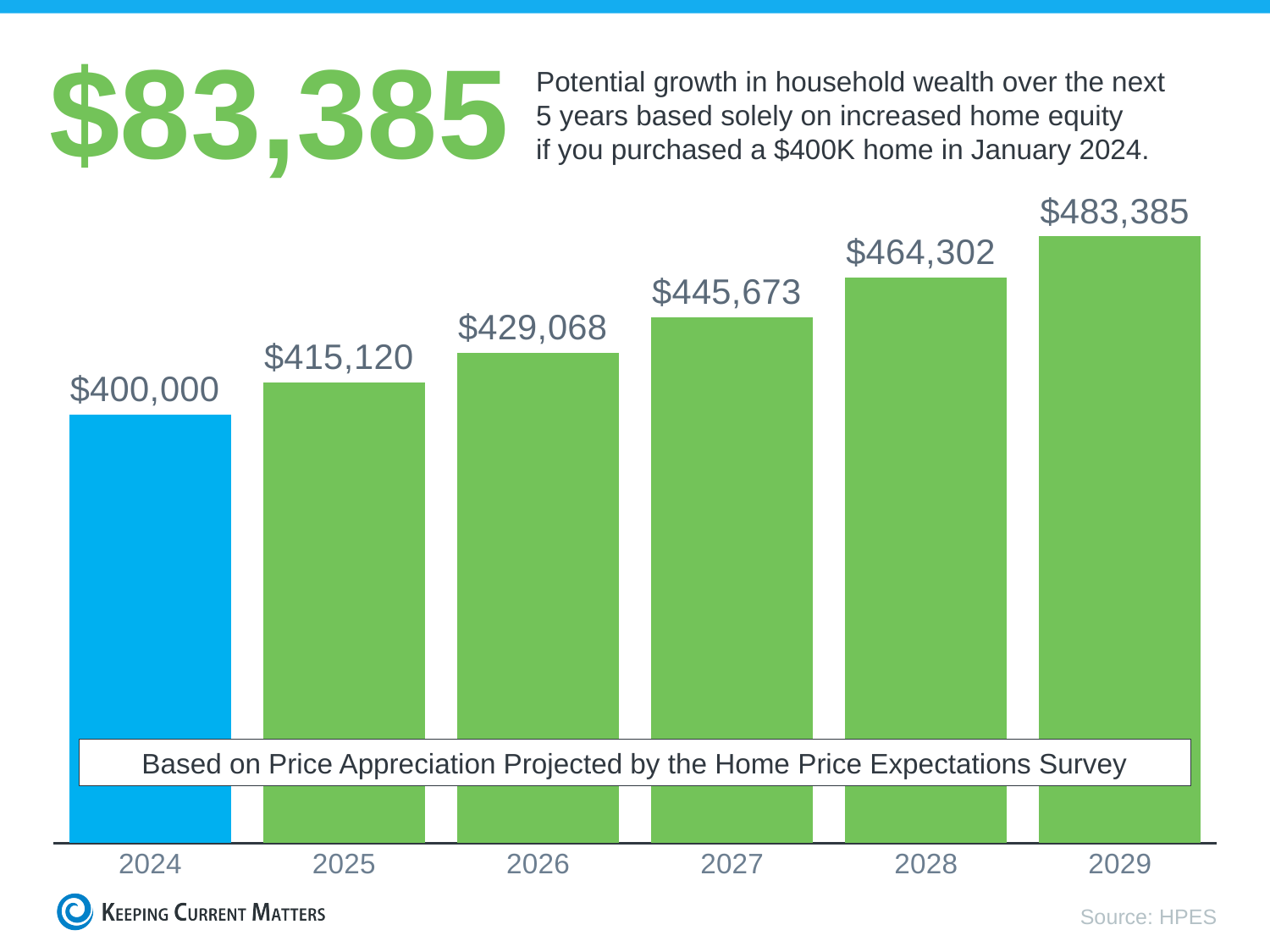
What is the value shown for 2029? $483,385 What is the difference between the values for 2029 and 2024? $83,385 How many years are shown on the x axis? 6 What kind of chart is this? Bar chart Which is larger, the value for 2028 or the value for 2026? 2028 Which year has the lowest value? 2024 Which bar is coloured differently from the others? 2024 What is the difference between the values for 2026 and 2025? $13,948 What is the value shown for 2024? $400,000 Which year has the highest value? 2029 Do the values rise or fall from 2024 to 2029? Rise What is the value shown for 2027? $445,673